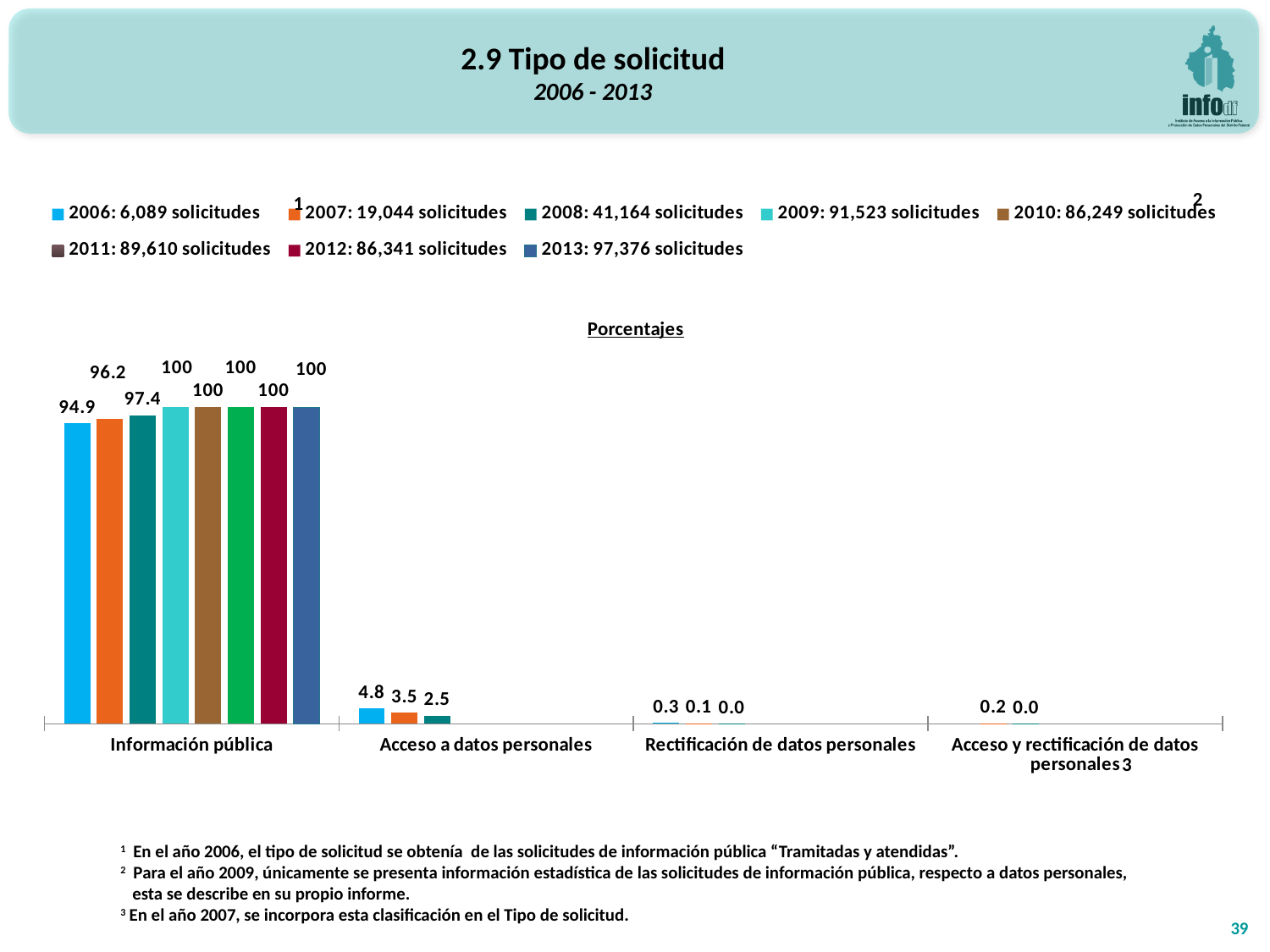
What is the difference between the 2006 and 2007 values in the Acceso a datos personales category? 1.3 Which is larger in the Acceso a datos personales category, the 2006 value or the 2008 value? 2006 What kind of chart is shown on the slide? Bar chart How many series does the legend list? 8 What percentage is shown for 2006 in the Información pública category? 94.9 Which category has the highest percentages across all years? Información pública What is the difference between the 2007 and 2006 values in the Información pública category? 1.3 According to the legend, how many solicitudes were there in 2013? 97,376 What percentage is shown for 2008 in the Información pública category? 97.4 What percentage is shown for 2008 in the Acceso a datos personales category? 2.5 What percentage is shown for 2006 in the Acceso a datos personales category? 4.8 How many categories are shown on the x axis? 4